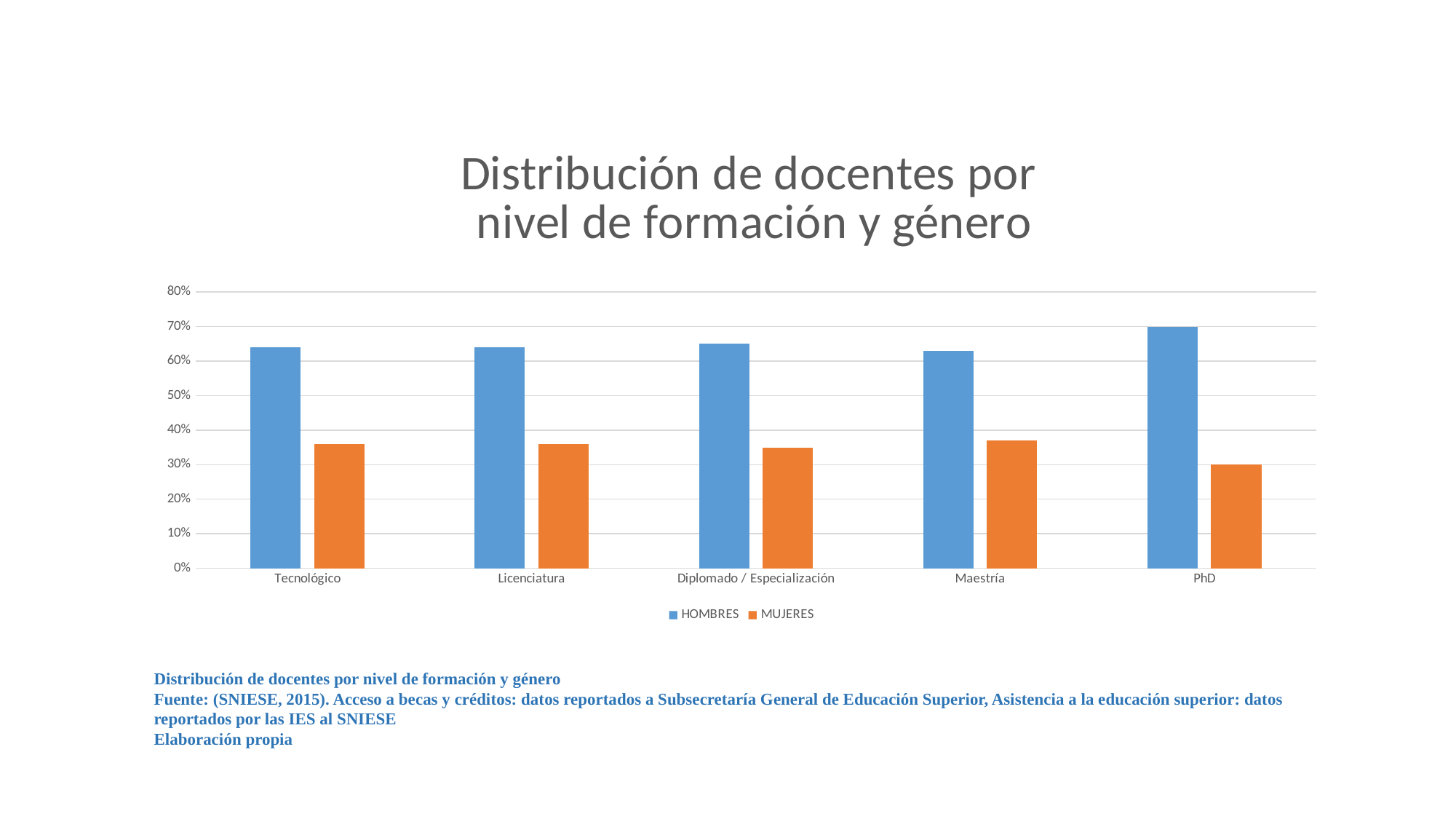
At Maestría, which series has the larger value, HOMBRES or MUJERES? HOMBRES Is the value for HOMBRES at Diplomado / Especialización greater or less than 60%? greater What kind of chart is shown on the slide? bar chart Which category has the lowest value for MUJERES? PhD How many series does the legend list? 2 Is the value for MUJERES at Licenciatura greater or less than 40%? less How many categories (levels of training) are shown on the x axis? 5 Which category has the highest value for HOMBRES? PhD Is the value for HOMBRES at Tecnológico greater or less than 60%? greater Which colour represents the MUJERES series? orange What is the title of the chart? Distribución de docentes por nivel de formación y género